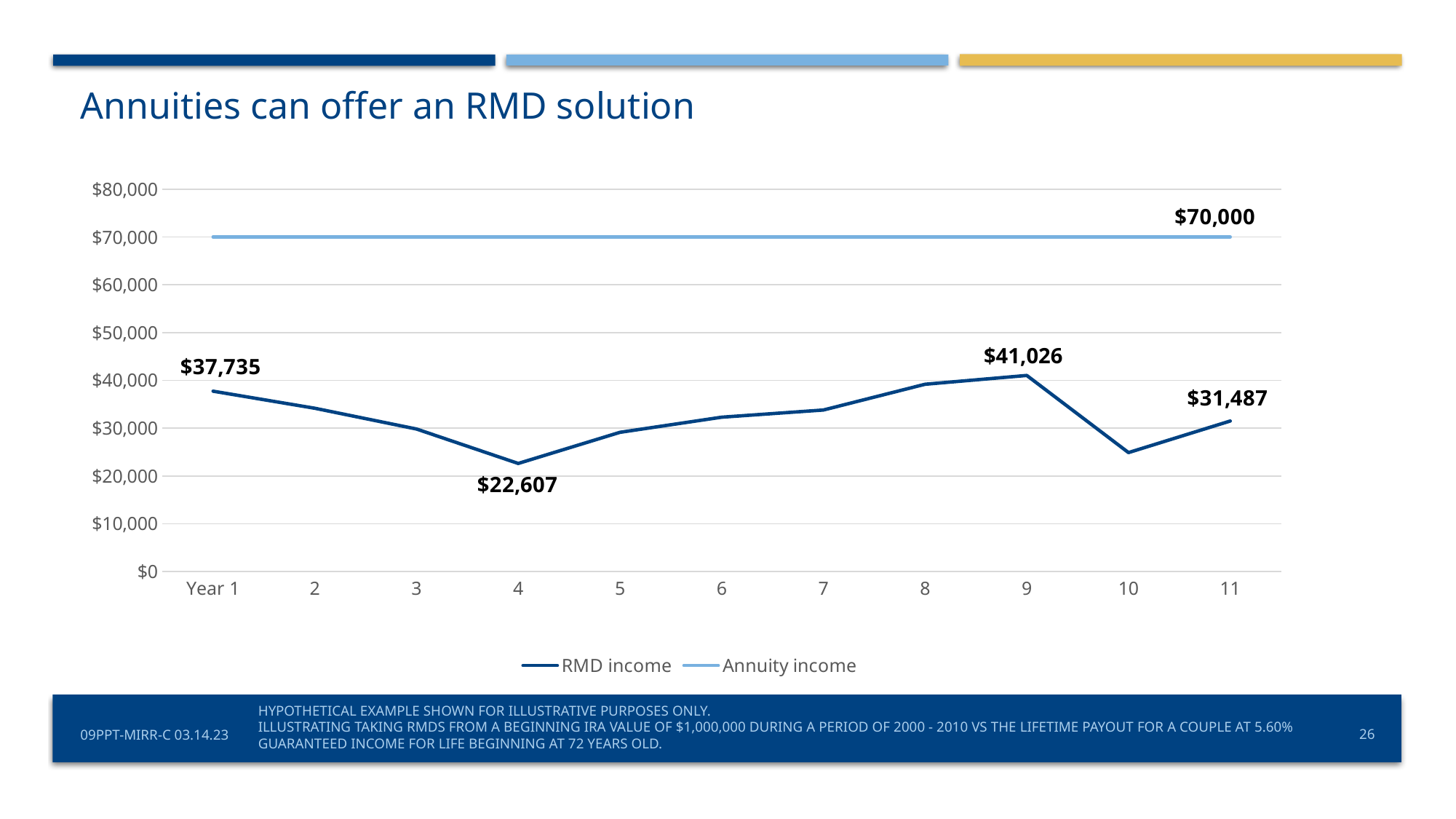
How many series does the legend list? 2 What is the RMD income in year 9? $41,026 Is the RMD income in year 10 greater or less than $30,000? less What is the Annuity income value shown on the chart? $70,000 What is the RMD income in year 11? $31,487 How many years are shown on the x axis? 11 In which year is RMD income lowest? 4 What is the RMD income in Year 1? $37,735 What type of chart is shown on the slide? Line chart What is the RMD income in year 4? $22,607 In which year is RMD income highest? 9 What is the difference between the RMD income in year 9 and in year 4? $18,419